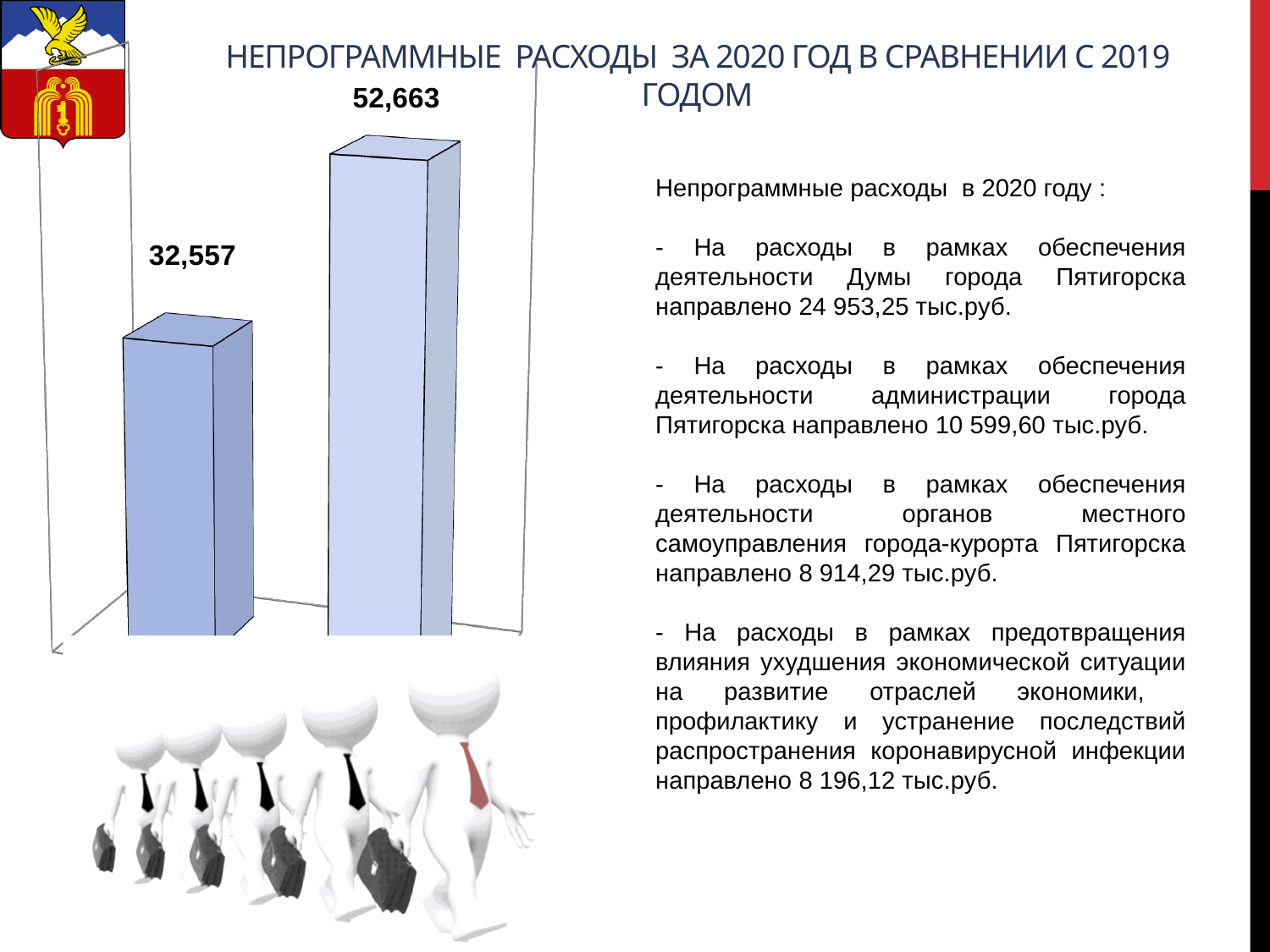
What is the difference between the values of the right bar and the left bar? 20,106 Are the bars in the chart drawn in a 3D style? yes Which bar has the higher value, the left or the right one? the right bar How many bars are plotted in the chart? 2 Which bar has the lower value, the left or the right one? the left bar What is the value shown on the left bar of the chart? 32,557 What kind of chart is shown on the slide? bar chart Is the value of the left bar larger or smaller than the value of the right bar? smaller What is the value shown on the right bar of the chart? 52,663 What is the title of the slide containing the chart? НЕПРОГРАММНЫЕ РАСХОДЫ ЗА 2020 ГОД В СРАВНЕНИИ С 2019 ГОДОМ Do the bar values rise or fall from left to right? rise